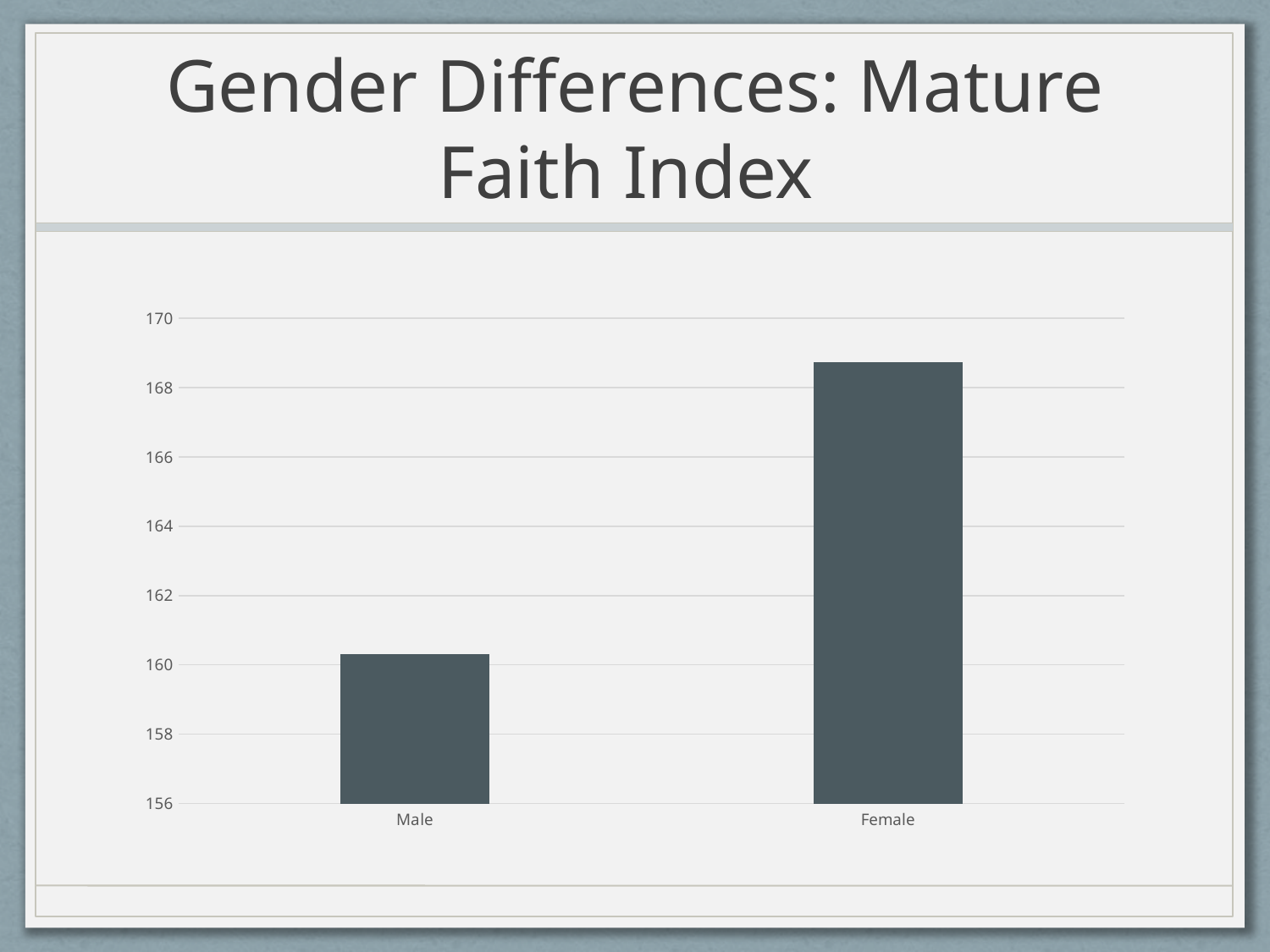
Is the value for Female greater or less than 164? greater Is the value for Male greater or less than 158? greater How many categories are plotted on the chart? 2 Is the value for Female greater or less than 170? less What kind of chart is shown on the slide? bar chart What is the title of the slide containing the chart? Gender Differences: Mature Faith Index What is the lowest value shown on the vertical axis of the chart? 156 Which is larger, the value for Male or the value for Female? Female Which category has the lowest value on the chart? Male Which category has the highest value on the chart? Female